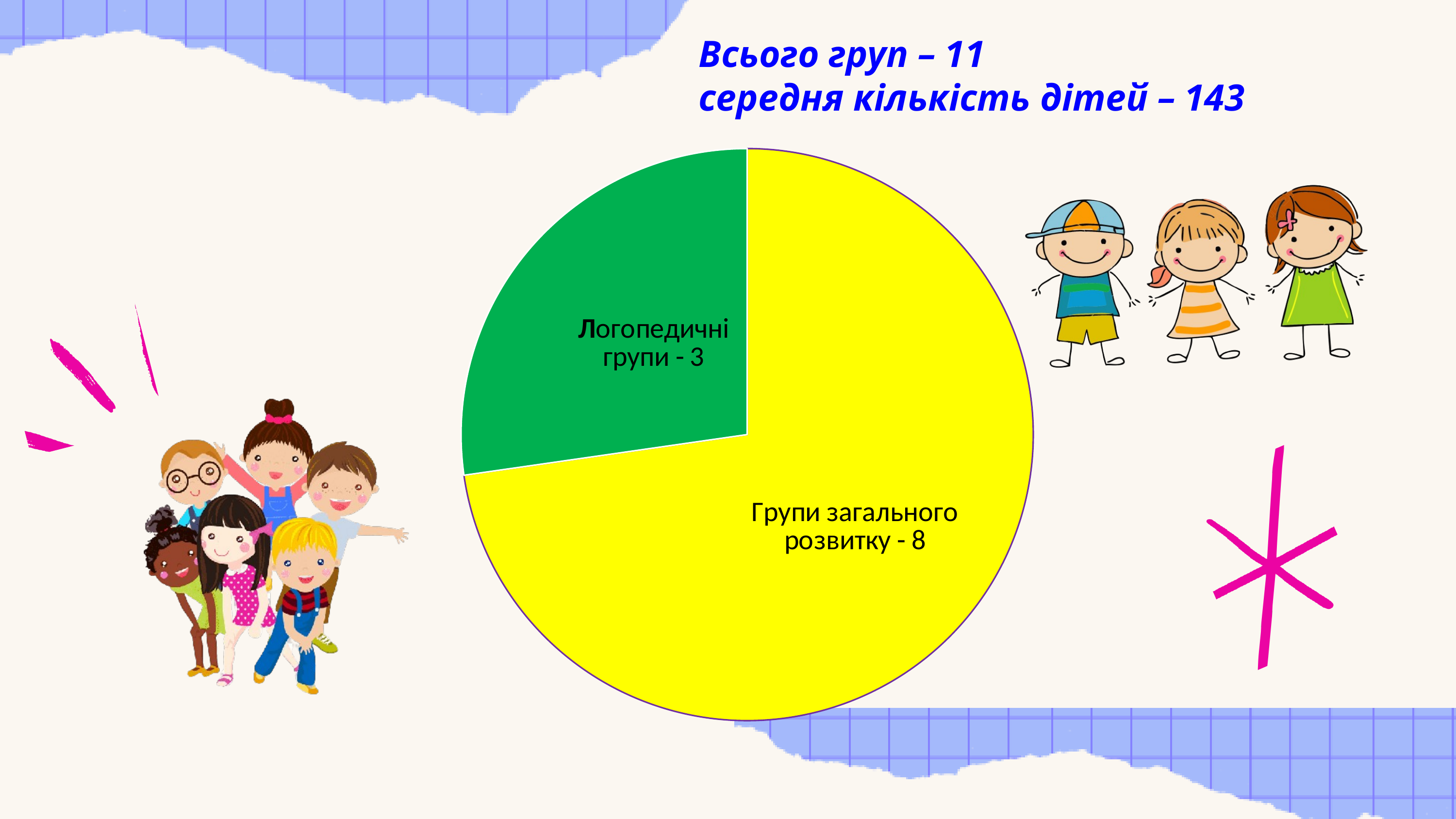
What is the value for Логопедичні групи? 3 Which slice of the pie chart is the smallest? Логопедичні групи What kind of chart is shown on the slide? pie chart What colour is the slice for Групи загального розвитку? yellow What is the value for Групи загального розвитку? 8 Which is larger: Логопедичні групи or Групи загального розвитку? Групи загального розвитку What colour is the slice for Логопедичні групи? green How many slices does the pie chart have? 2 What is the total of the two slices in the pie chart? 11 Which slice of the pie chart is the largest? Групи загального розвитку What is the difference between the value for Групи загального розвитку and the value for Логопедичні групи? 5